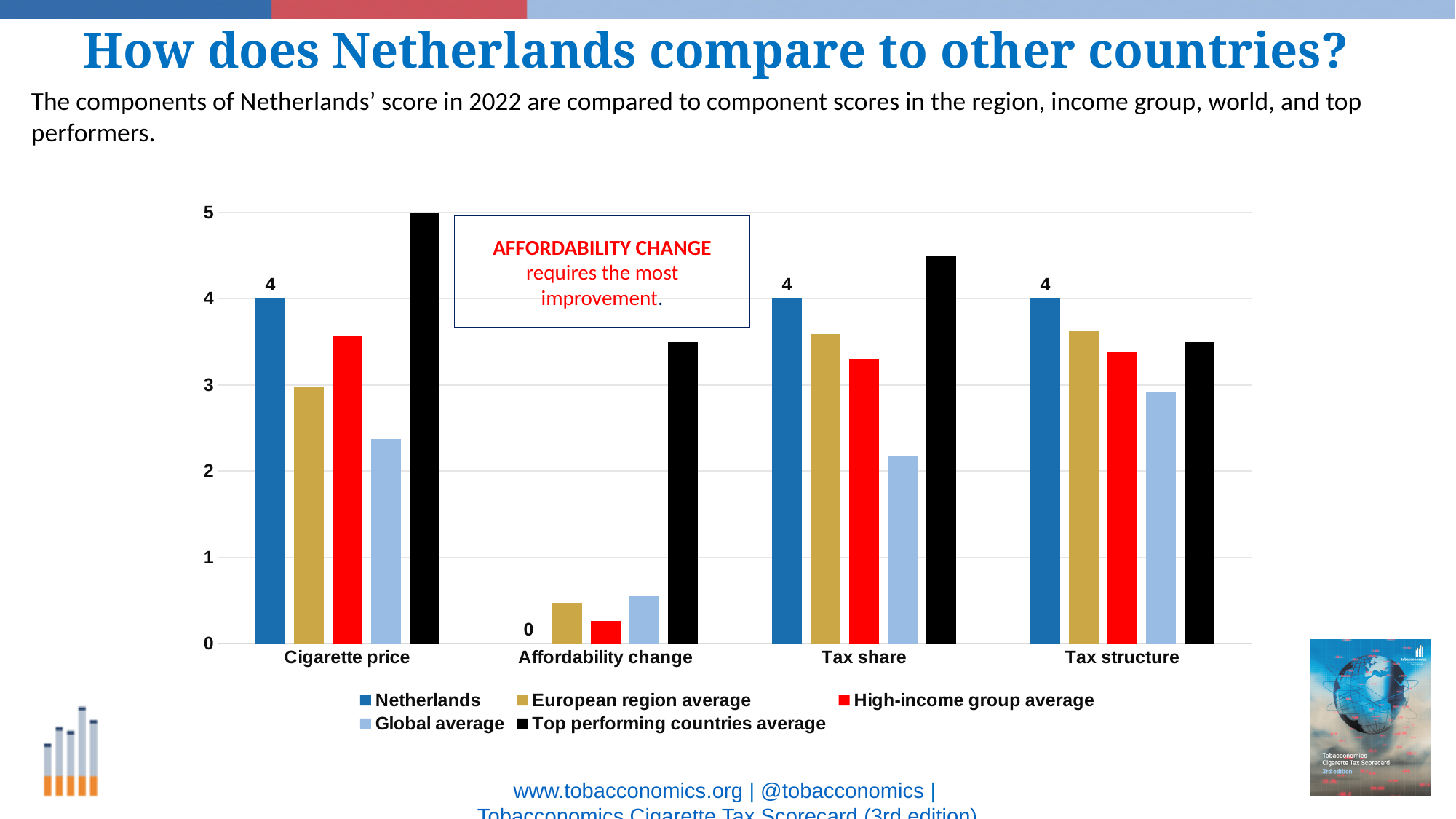
What kind of chart is shown on the slide? Bar chart What is the Netherlands score for Affordability change? 0 Is the Top performing countries average for Tax share greater or less than 4? greater What is the Top performing countries average for Cigarette price? 5 What is the Netherlands score for Tax structure? 4 For Cigarette price, which is larger: the Netherlands score or the Global average? Netherlands For which component is the Netherlands score lowest? Affordability change Is the Global average for Tax share greater or less than 3? less Is the European region average for Affordability change greater or less than 1? less How many series does the legend list? 5 How many components (categories) are shown on the x axis? 4 What is the Netherlands score for Cigarette price? 4